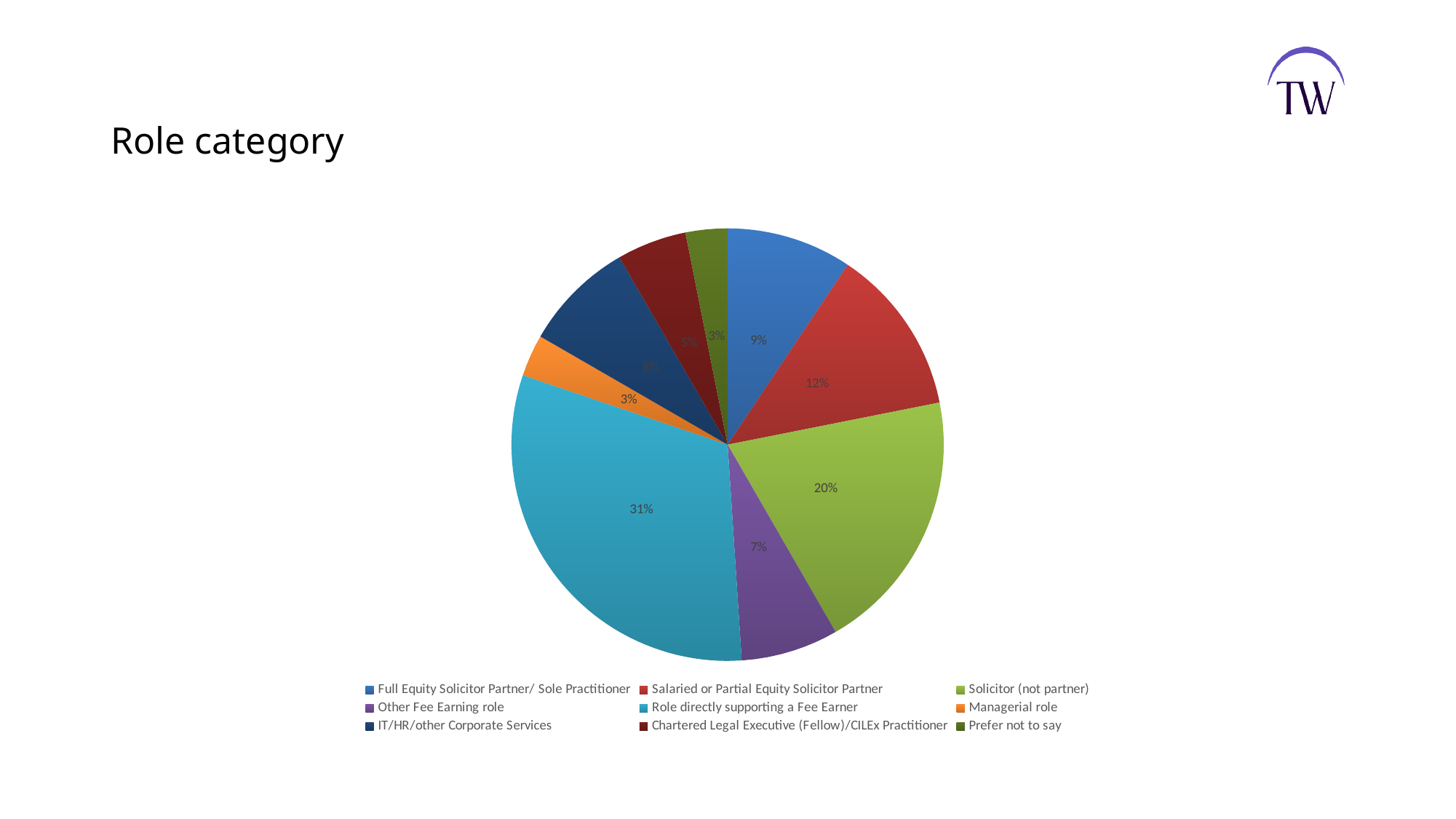
Which is larger: the share for 'Other Fee Earning role' or the share for 'Salaried or Partial Equity Solicitor Partner'? Salaried or Partial Equity Solicitor Partner What share of the pie is 'Role directly supporting a Fee Earner'? 31% What is the title of the chart? Role category What share of the pie is 'Solicitor (not partner)'? 20% What share of the pie is 'Full Equity Solicitor Partner/ Sole Practitioner'? 9% Which role category has the largest share of the pie? Role directly supporting a Fee Earner How many categories does the legend list? 9 What is the difference in percentage points between 'Role directly supporting a Fee Earner' and 'Solicitor (not partner)'? 11 percentage points What type of chart is shown on the slide? Pie chart